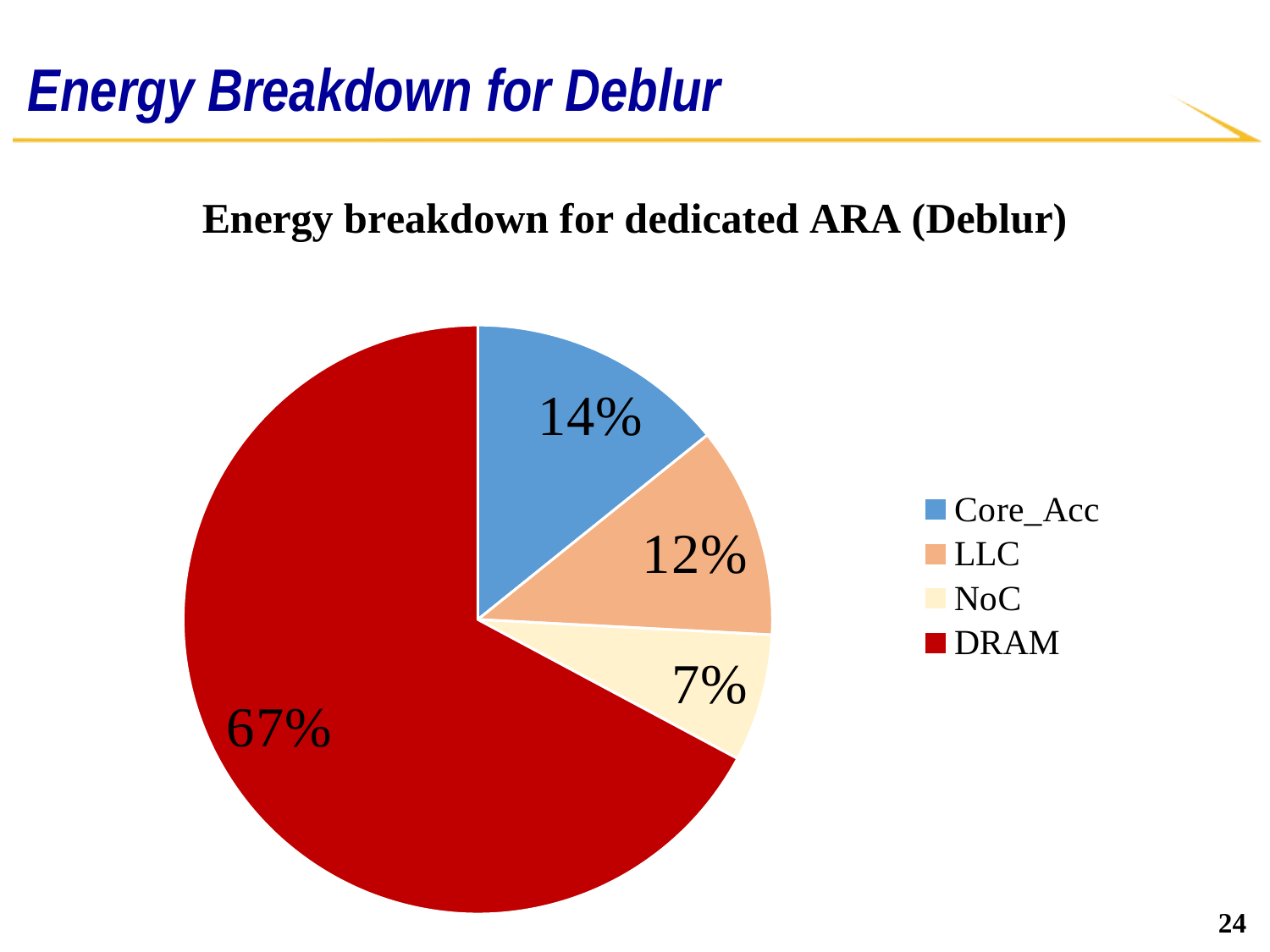
How many slices does the pie chart have? 4 What is the difference in percentage points between the DRAM share and the Core_Acc share? 53 What share of energy does Core_Acc account for? 14% Which has a larger share, LLC or NoC? LLC Which component has the largest share of energy? DRAM How many entries does the legend list? 4 What share of energy does NoC account for? 7% What share of energy does DRAM account for? 67% What is the title of the chart? Energy breakdown for dedicated ARA (Deblur) Which component has the smallest share of energy? NoC What type of chart is shown on the slide? pie chart